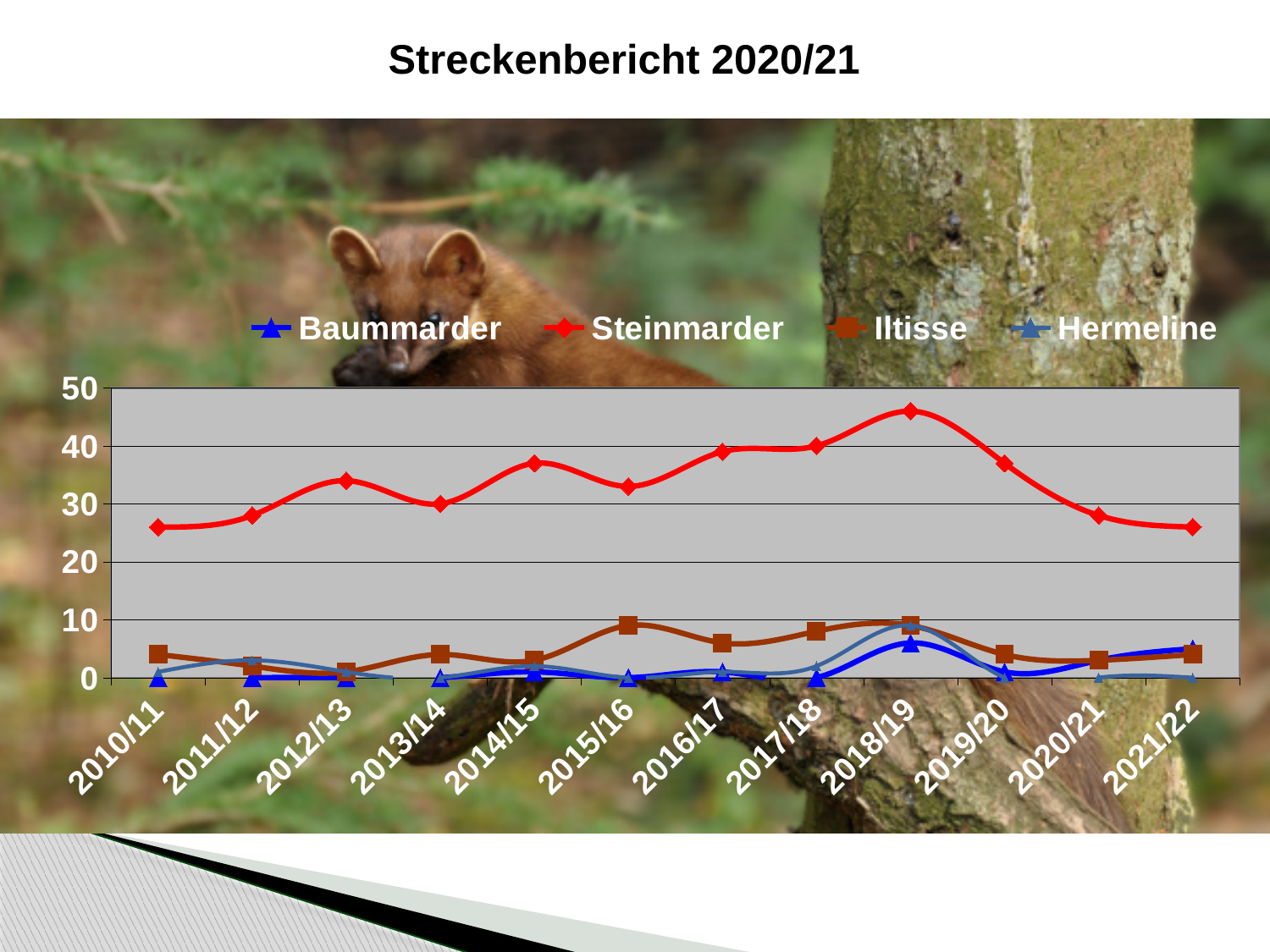
For the Steinmarder series, which season has the larger value, 2014/15 or 2015/16? 2014/15 In which season does the Steinmarder series reach its highest value? 2018/19 Is the Steinmarder value for 2010/11 greater or less than 30? less Is the Steinmarder value for 2012/13 greater or less than 30? greater In 2015/16, which series has the larger value, Steinmarder or Iltisse? Steinmarder How many hunting seasons are shown along the x axis? 12 Does the Steinmarder series rise or fall from 2018/19 to 2021/22? fall What kind of chart is shown on the slide? line chart How many series does the legend list? 4 Which series is drawn in red? Steinmarder Is the Steinmarder value for 2018/19 greater or less than 40? greater